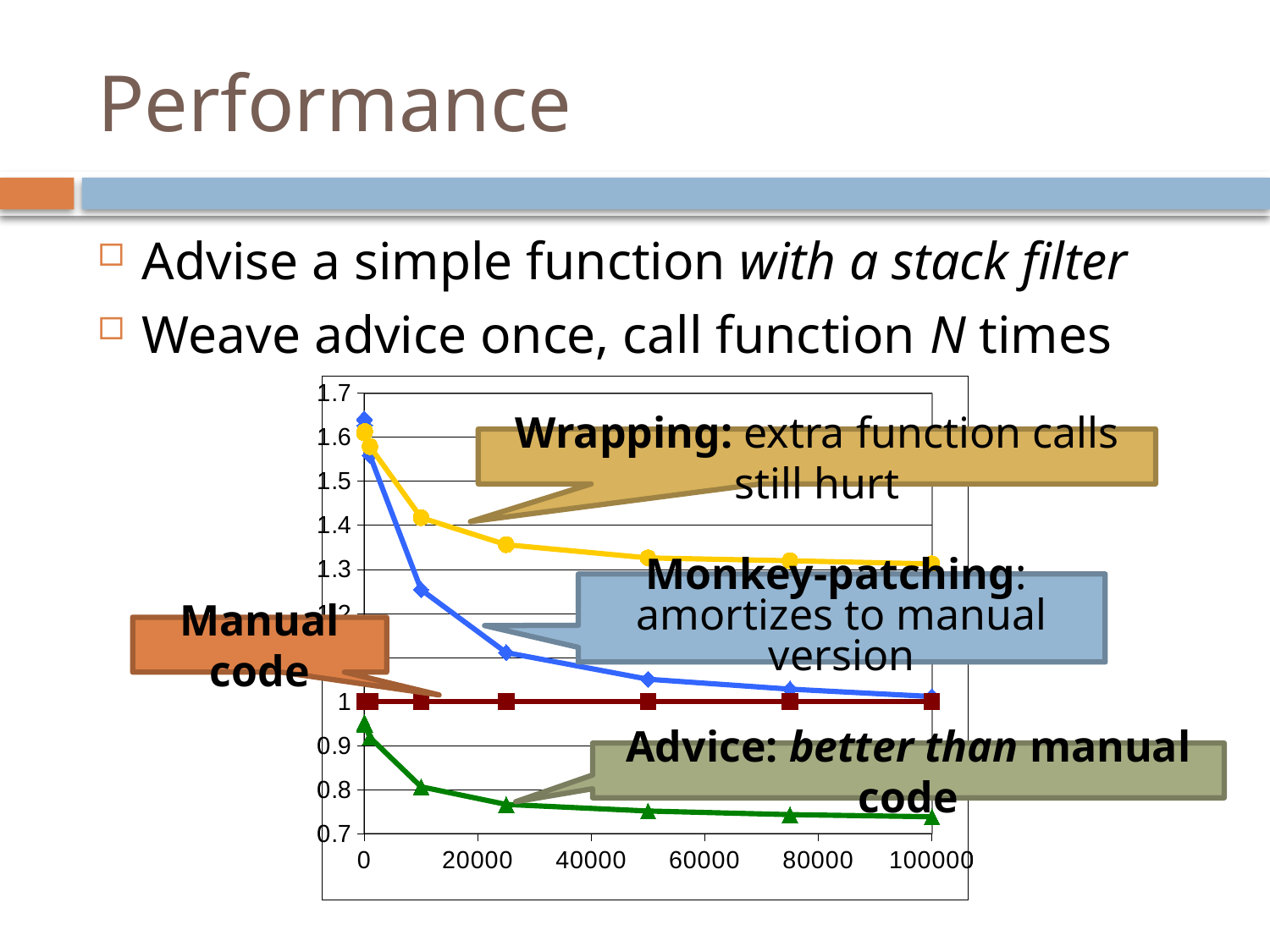
What value does the Manual code line stay at across the x axis? 1 Does the Advice line rise or fall as the x axis increases? fall Is the value for Wrapping at x = 100000 greater or less than 1.2? greater Is the value for Advice at x = 100000 greater or less than 0.8? less What kind of chart is shown on the slide? line chart Which series has the lowest value at x = 100000? Advice Which series has the highest value at x = 100000? Wrapping How many lines (series) are plotted on the chart? 4 At x = 100000, which is larger: the Wrapping value or the Monkey-patching value? Wrapping What colour is the Advice line on the chart? green Does the Wrapping line rise or fall as the x axis increases? fall